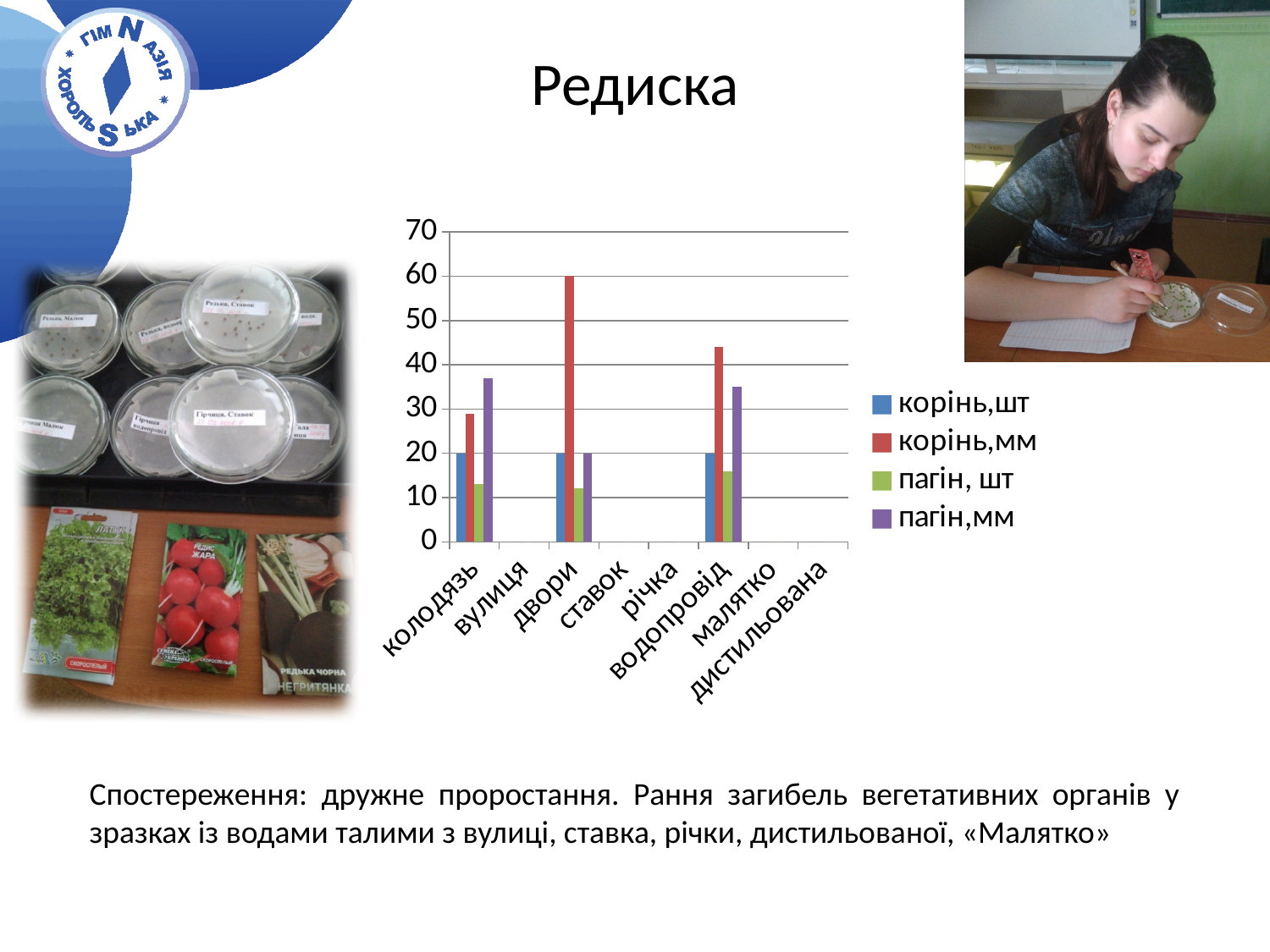
Is the value of корінь,мм for колодязь greater or less than 40? less What is the value of корінь,шт for колодязь? 20 Which has the larger value for корінь,мм: колодязь or водопровід? водопровід What is the title of the slide containing the chart? Редиска What kind of chart is shown on the slide? bar chart Which has the larger value for пагін,мм: двори or водопровід? водопровід How many series does the chart legend list? 4 What is the value of корінь,мм for двори? 60 What is the value of пагін,мм for двори? 20 How many categories are shown on the x axis of the chart? 8 Which category has the highest value for корінь,мм? двори Is the value of корінь,мм for водопровід greater or less than 40? greater